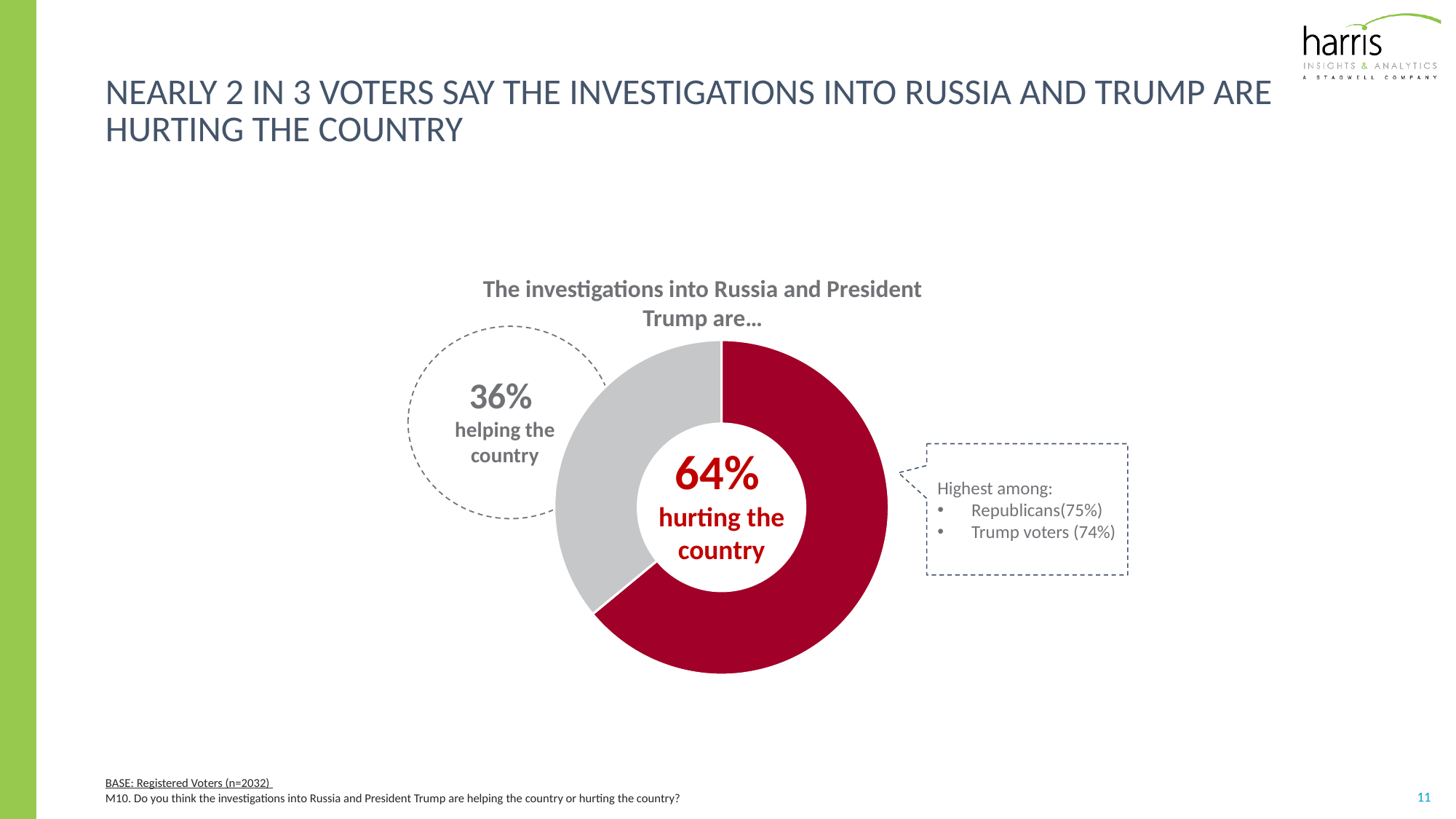
How many categories are shown in the chart? 2 What percentage of voters say the investigations are helping the country? 36% What percentage of voters say the investigations are hurting the country? 64% What kind of chart is shown on the slide? pie chart (doughnut) What is the difference in percentage points between 'hurting the country' and 'helping the country'? 28 What is the title of the chart? The investigations into Russia and President Trump are… According to the callout, what percentage of Republicans say the investigations are hurting the country? 75% Which response has the larger share of the chart? hurting the country What colour is the 'hurting the country' segment of the chart? red Is the share for 'helping the country' larger or smaller than the share for 'hurting the country'? smaller According to the callout, what percentage of Trump voters say the investigations are hurting the country? 74% Which response has the smaller share of the chart? helping the country